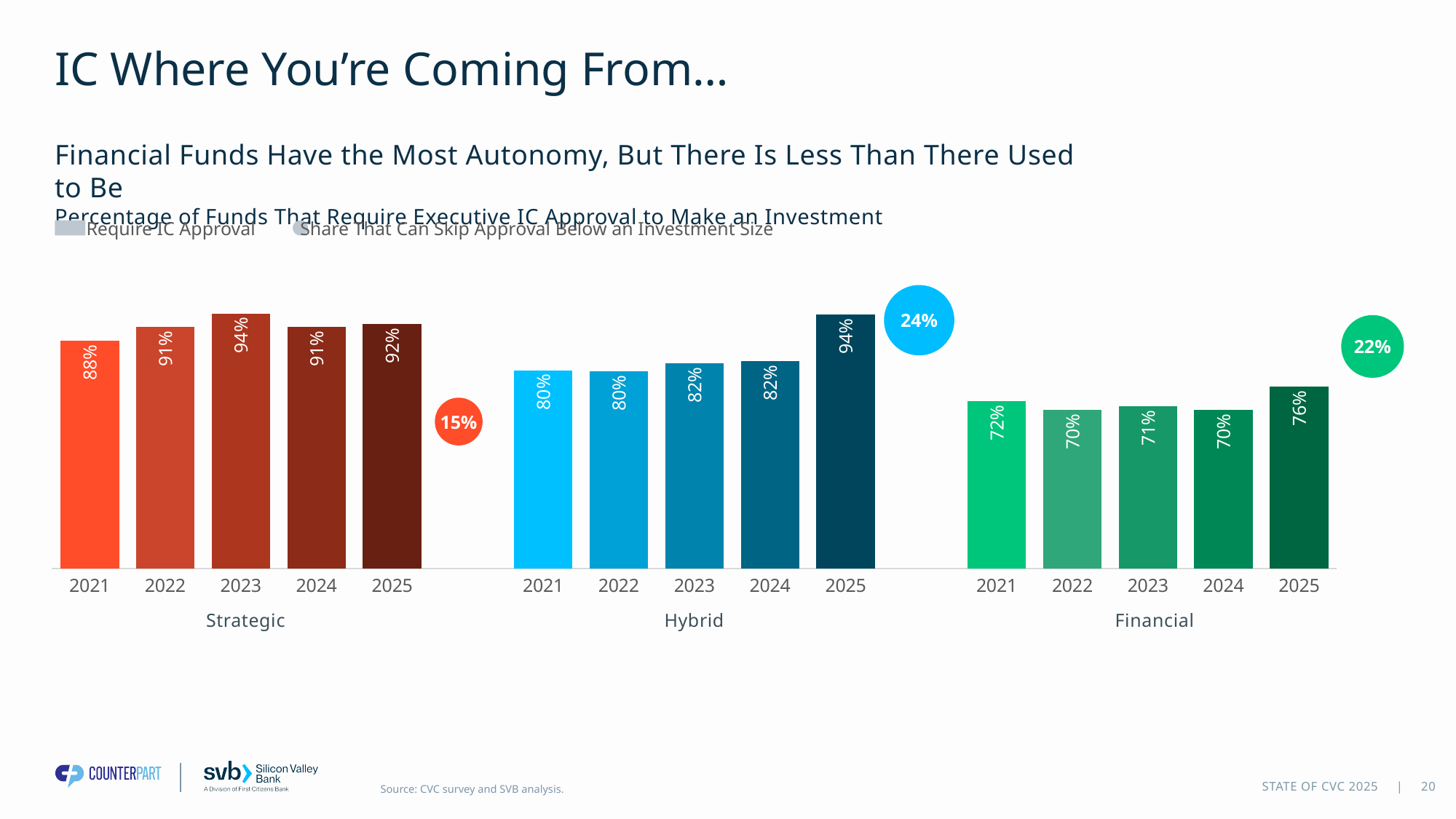
Which year has the lowest value in the Financial group? 2022 and 2024 (70%) What share of Strategic funds can skip approval below an investment size? 15% Which is larger: the Strategic 2021 value or the Financial 2025 value? Strategic 2021 (88%) What percentage of Financial funds required IC approval in 2025? 76% What kind of chart is shown on the slide? Bar chart What percentage of Strategic funds required IC approval in 2023? 94% How many fund groups are shown on the x axis? 3 What share of Hybrid funds can skip approval below an investment size? 24% What percentage of Hybrid funds required IC approval in 2021? 80% What is the difference between the Hybrid 2025 value and the Hybrid 2024 value? 12 percentage points Which year has the highest value in the Hybrid group? 2025 How many bars are plotted in total on the chart? 15